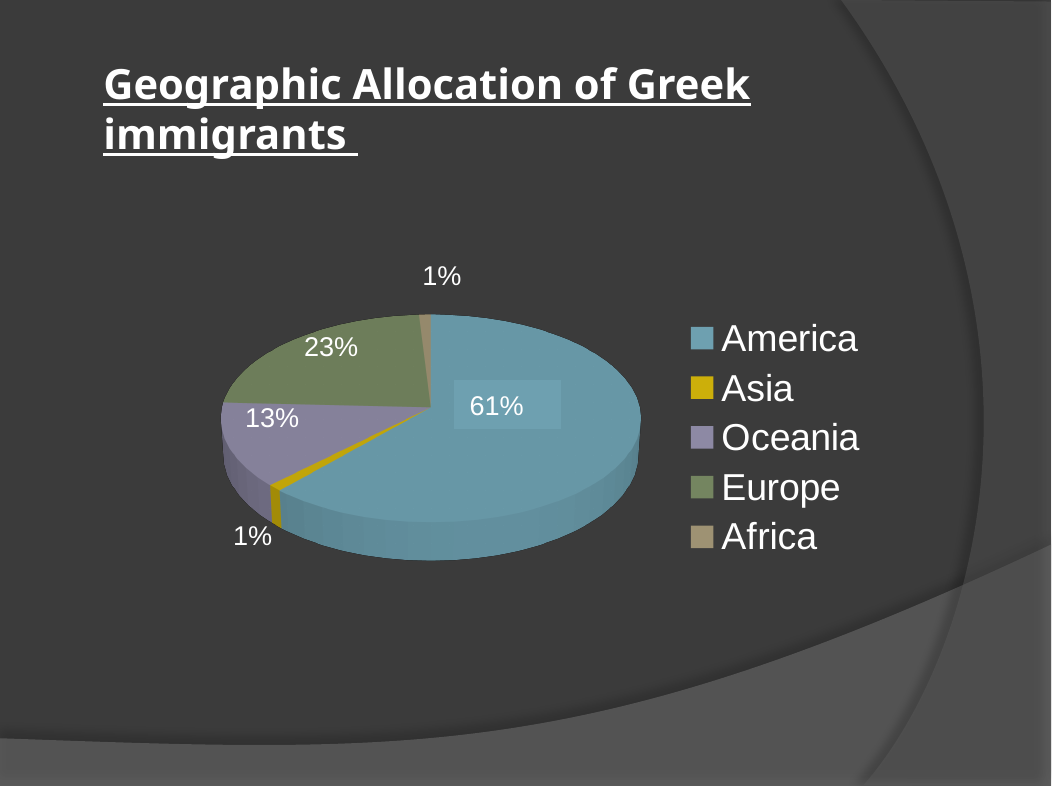
How many entries does the legend list? 5 What type of chart is shown on the slide? Pie chart Which region has the largest slice of the pie? America How many regions are shown in the pie chart? 5 What is the difference in percentage points between Europe and Oceania? 10 What is the title of the slide containing the chart? Geographic Allocation of Greek immigrants What percentage is shown for Europe? 23% Which slice is larger, Oceania or Europe? Europe What is the difference in percentage points between America and Europe? 38 What percentage is shown for Oceania? 13% What share of the pie does America account for? 61% What percentage is shown for Asia? 1%